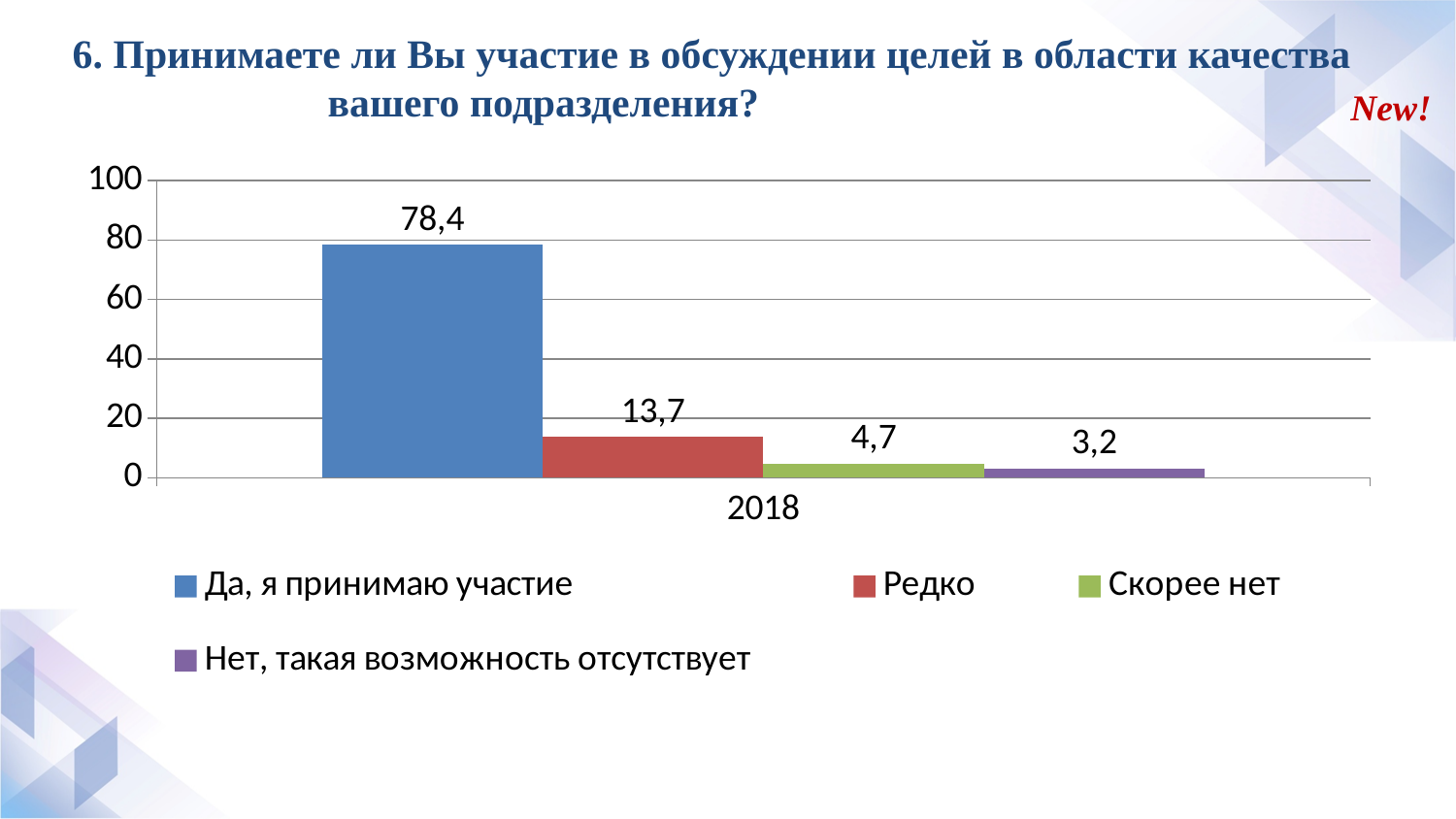
What is the value for "Редко" in 2018? 13,7 What is the difference between the values for "Да, я принимаю участие" and "Редко"? 64,7 What is the value for "Скорее нет" in 2018? 4,7 Which series has the lowest value? Нет, такая возможность отсутствует Which series has the highest value? Да, я принимаю участие What is the value for "Нет, такая возможность отсутствует" in 2018? 3,2 Which is larger, the value for "Скорее нет" or the value for "Нет, такая возможность отсутствует"? Скорее нет What kind of chart is shown on the slide? bar chart Which year is shown on the x axis of the chart? 2018 What is the value for "Да, я принимаю участие" in 2018? 78,4 Is the value for "Редко" greater or less than 20? less How many series does the legend list? 4